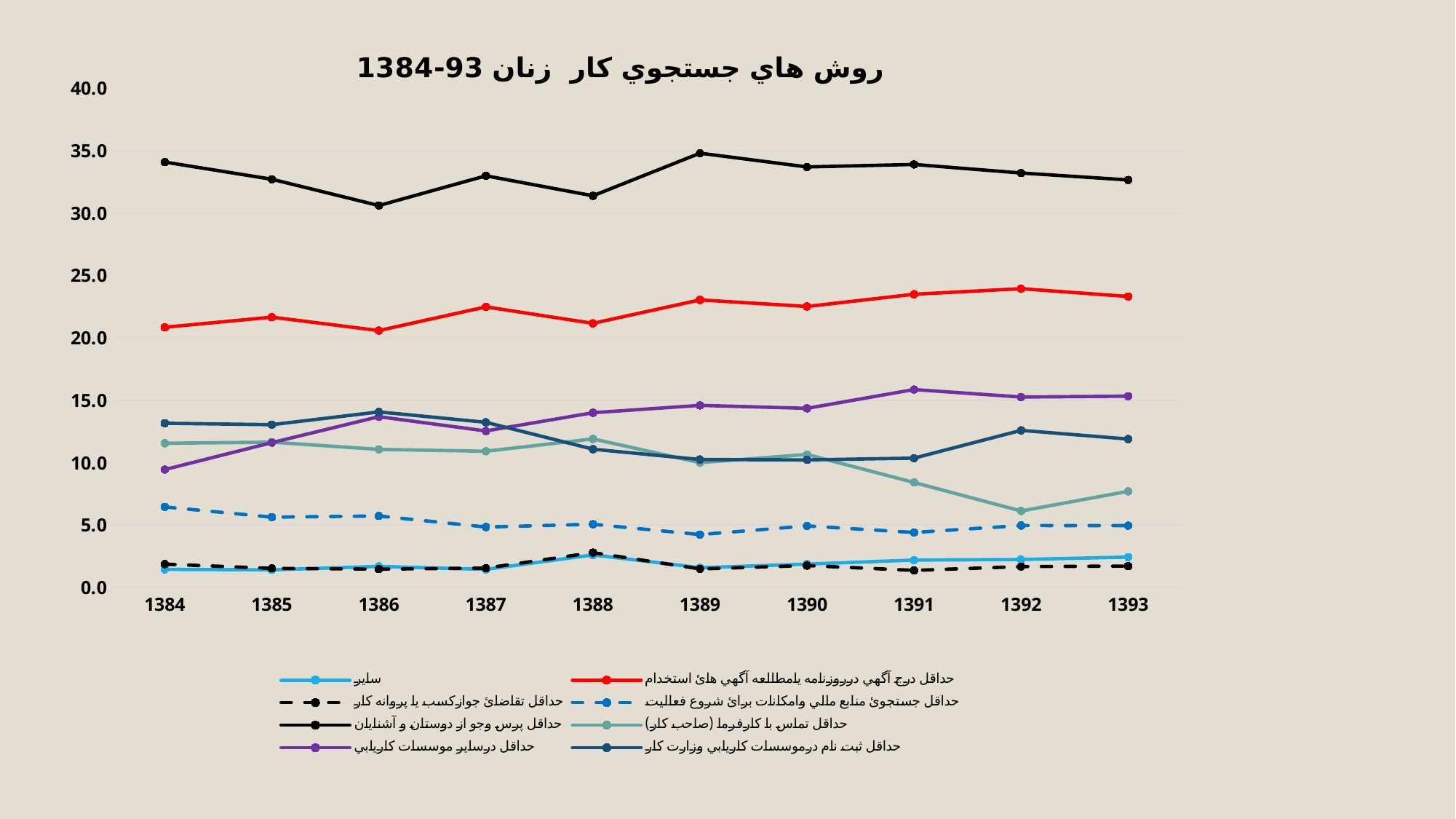
What kind of chart is shown on the slide? line chart Which series has the highest values across all years? حداقل پرس و جو از دوستان و آشنايان In 1393, which is larger: the value for حداقل درج آگهي در روزنامه يا مطالعه آگهي هاي استخدام or the value for حداقل در ساير موسسات كاريابي? حداقل درج آگهي در روزنامه يا مطالعه آگهي هاي استخدام Is the value for حداقل جستجوي منابع مالي و امكانات براي شروع فعاليت in 1389 greater or less than 5? less What is the title of the chart? روش هاي جستجوي كار زنان 1384-93 Is the value for حداقل پرس و جو از دوستان و آشنايان in 1389 greater or less than 30? greater Is the value for حداقل تماس با كارفرما (صاحب كار) in 1392 greater or less than 10? less Does the line for حداقل تماس با كارفرما (صاحب كار) rise or fall overall from 1384 to 1393? fall How many series does the legend list? 8 Does the line for حداقل در ساير موسسات كاريابي rise or fall overall from 1384 to 1393? rise How many years are plotted along the x axis? 10